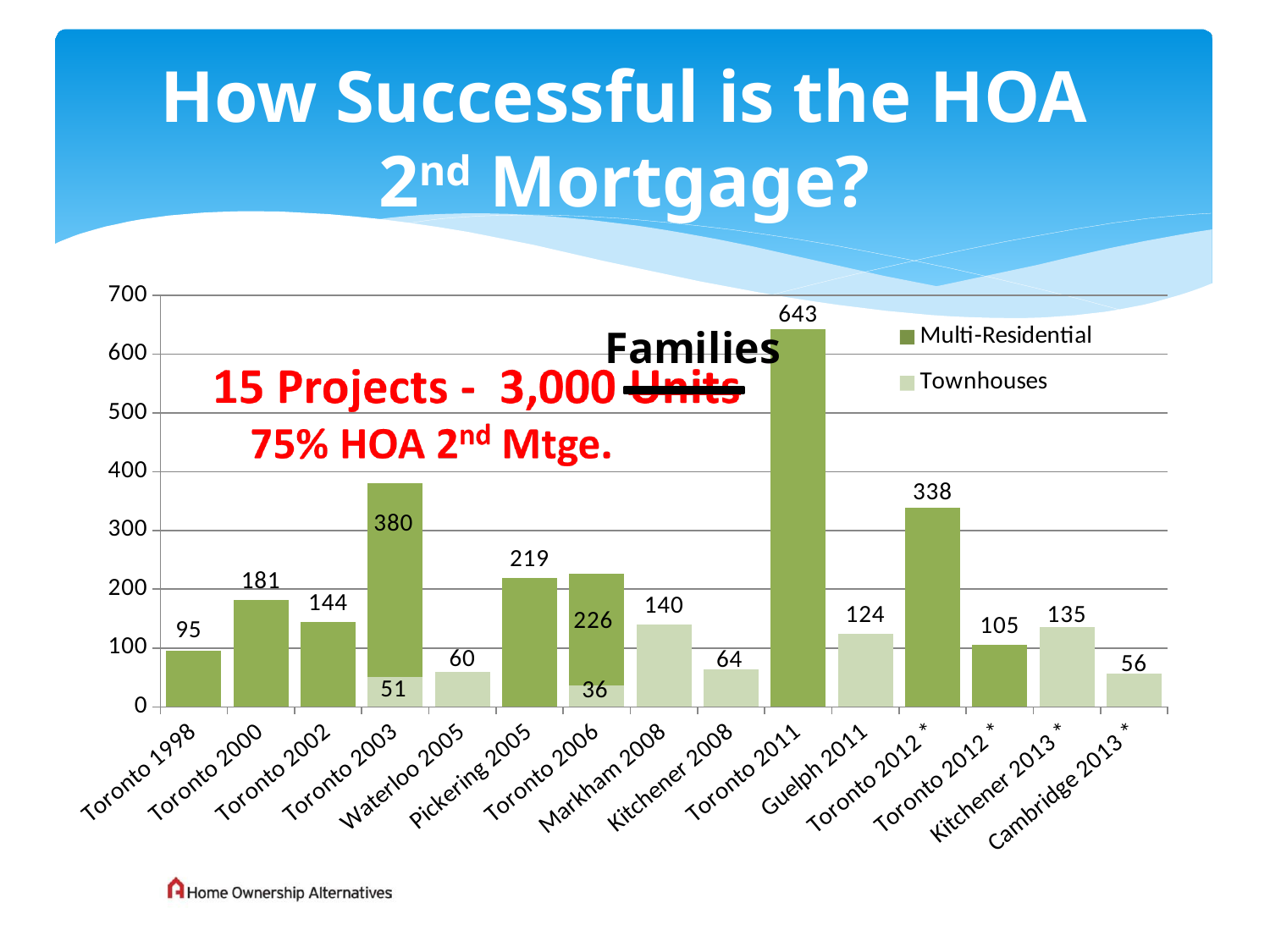
Which project has the lowest Townhouses value? Toronto 2006 How many series does the chart legend list? 2 What is the Multi-Residential value for Toronto 2011? 643 What is the Townhouses value for Markham 2008? 140 What is the total of the stacked bar for Toronto 2003 (Multi-Residential plus Townhouses)? 431 What is the difference between the Multi-Residential values for Toronto 2000 and Toronto 1998? 86 What is the total of the stacked bar for Toronto 2006 (Multi-Residential plus Townhouses)? 262 What kind of chart is shown on the slide? bar chart Which project has the highest Multi-Residential value? Toronto 2011 Which has the larger Townhouses value, Guelph 2011 or Kitchener 2013 *? Kitchener 2013 * What is the Multi-Residential value for Pickering 2005? 219 What are the two series named in the chart legend? Multi-Residential and Townhouses